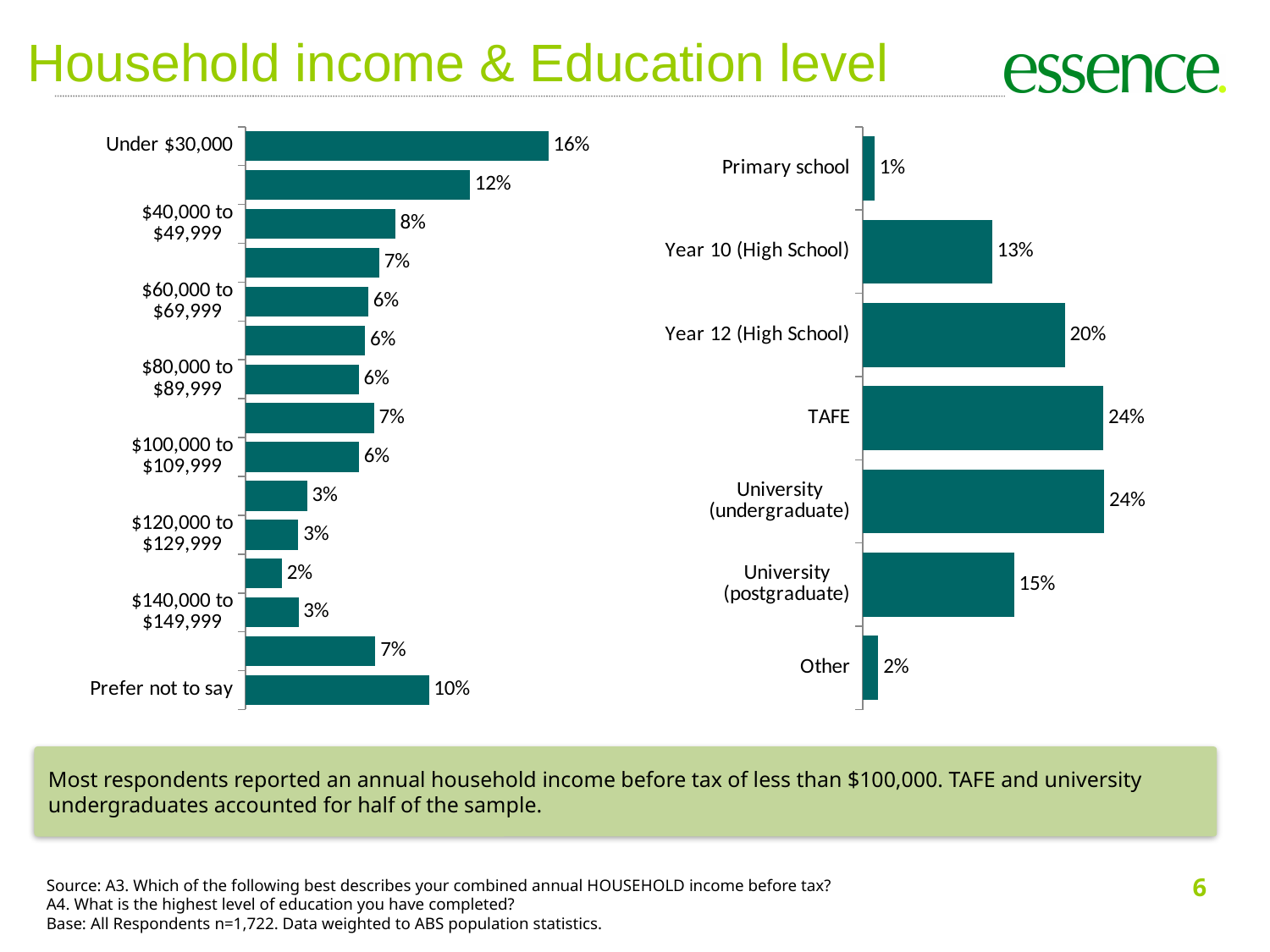
In the education level chart on the right, which is larger: University (postgraduate) or Year 10 (High School)? University (postgraduate) What is the title of the slide? Household income & Education level In the education level chart on the right, what percentage of respondents completed Year 12 (High School)? 20% In the household income chart on the left, which labelled category has the highest value? Under $30,000 In the household income chart on the left, what percentage of respondents reported income Under $30,000? 16% In the education level chart on the right, what is the value for University (postgraduate)? 15% In the education level chart on the right, what is the difference between Year 12 (High School) and Year 10 (High School)? 7% In the household income chart on the left, what is the value for Prefer not to say? 10% What type of chart is the education level chart on the right? Bar chart In the household income chart on the left, what is the difference between Under $30,000 and $40,000 to $49,999? 8% In the education level chart on the right, which category has the lowest value? Primary school How many categories are shown in the education level chart on the right? 7